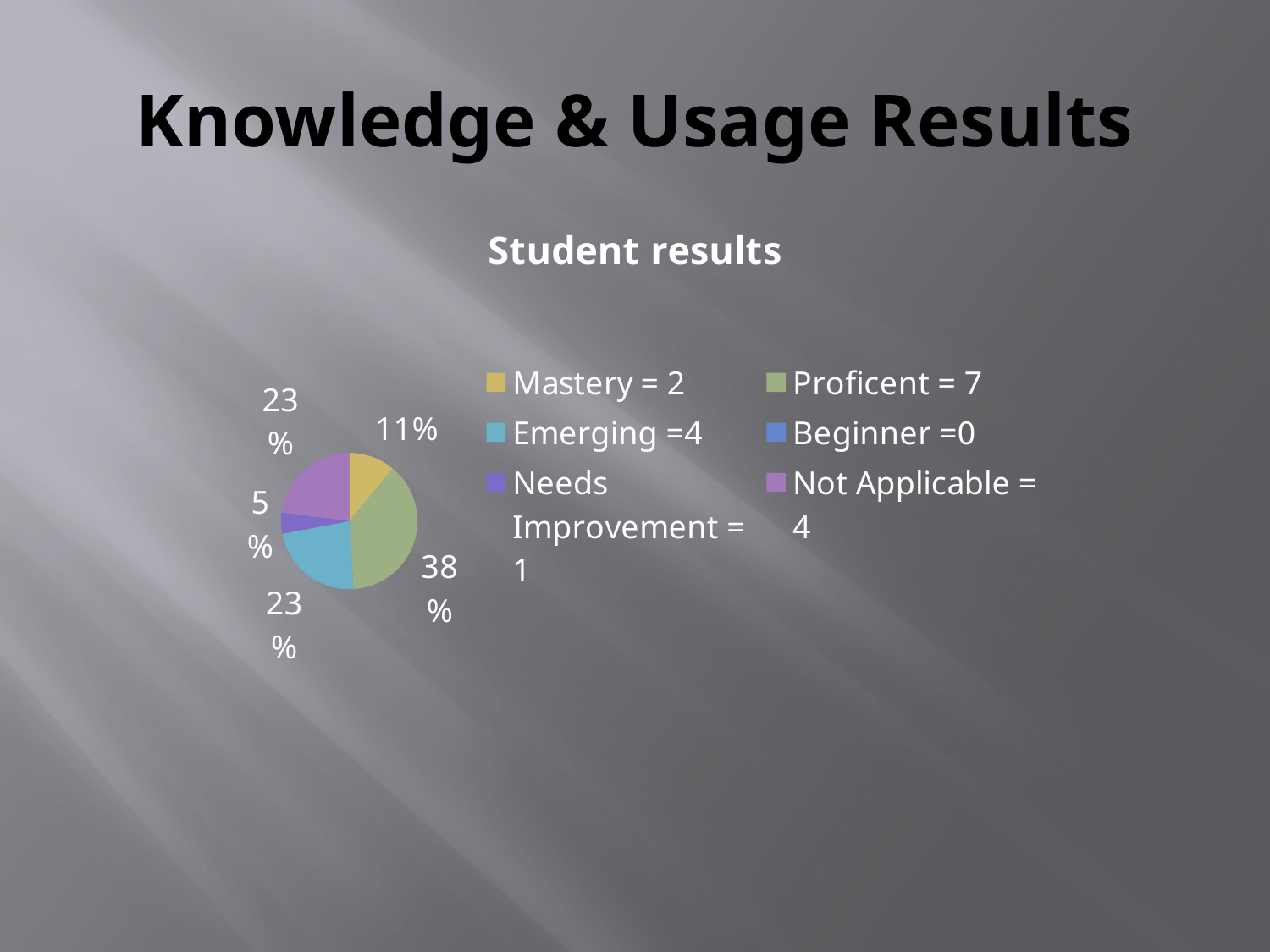
What kind of chart is shown on the slide? pie chart What percentage of the pie does the Needs Improvement slice represent? 5% Which is larger, the Emerging slice or the Needs Improvement slice? Emerging What percentage of the pie does the Not Applicable slice represent? 23% What percentage of the pie does the Proficent slice represent? 38% What is the difference in percentage points between the Proficent slice and the Mastery slice? 27 What is the title of the chart? Student results Which category with a visible slice has the smallest share of the pie? Needs Improvement How many entries does the chart's legend list? 6 Which category has the largest slice of the pie? Proficent